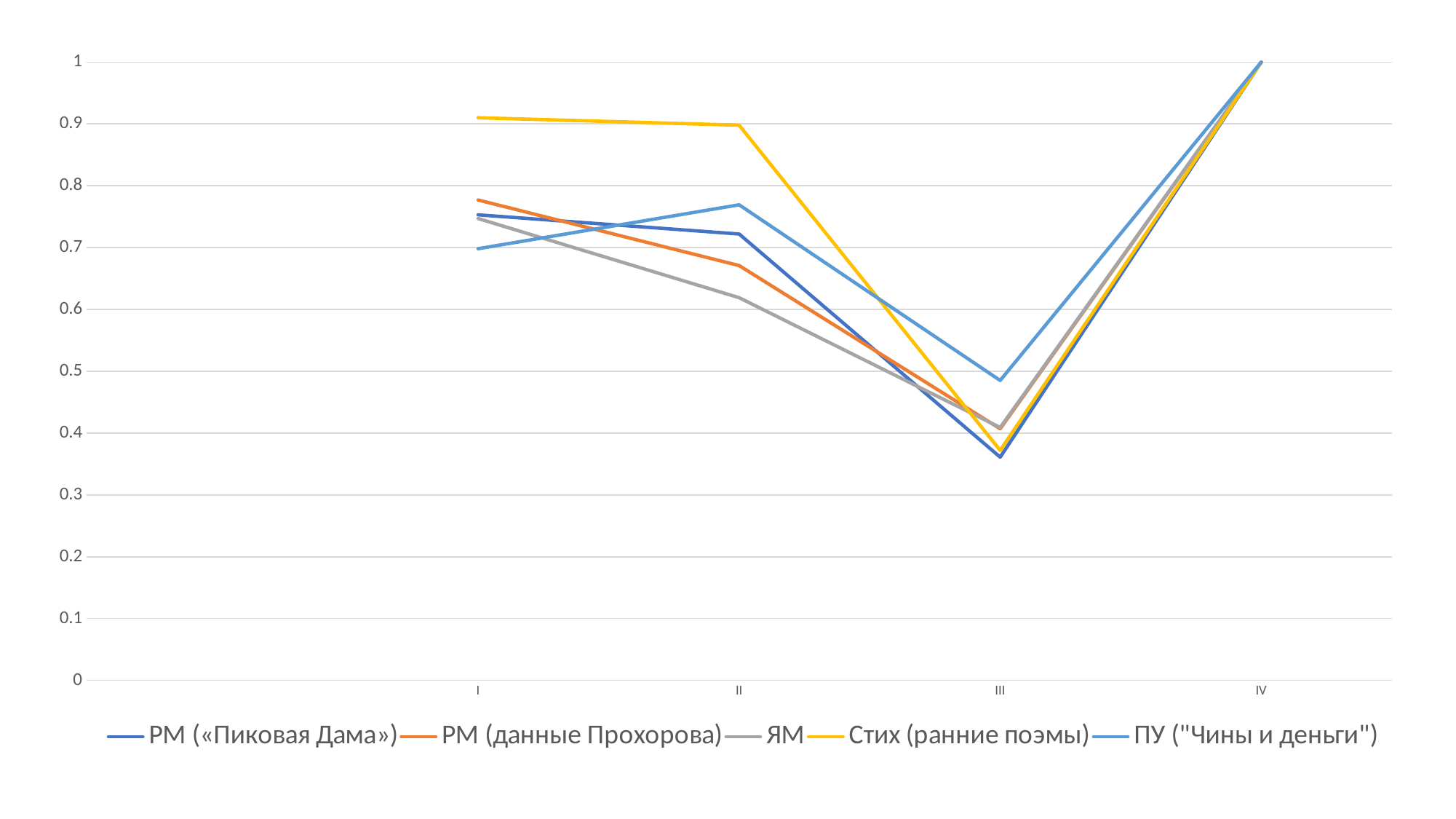
Which series has the lowest value at category II? ЯМ Does the Стих (ранние поэмы) series rise or fall from category I to category III? fall What is the value of the Стих (ранние поэмы) series at category IV? 1 What kind of chart is shown on the slide? line chart How many categories are shown on the x axis? 4 Is the value of Стих (ранние поэмы) at category I greater or less than 0.8? greater At category II, which is larger: ПУ ("Чины и деньги") or РМ («Пиковая Дама»)? ПУ ("Чины и деньги") Which series has the highest value at category I? Стих (ранние поэмы) How many series does the legend list? 5 Is the value of ПУ ("Чины и деньги") at category III greater or less than 0.4? greater Which series has the highest value at category III? ПУ ("Чины и деньги") Is the value of ЯМ at category II greater or less than 0.7? less